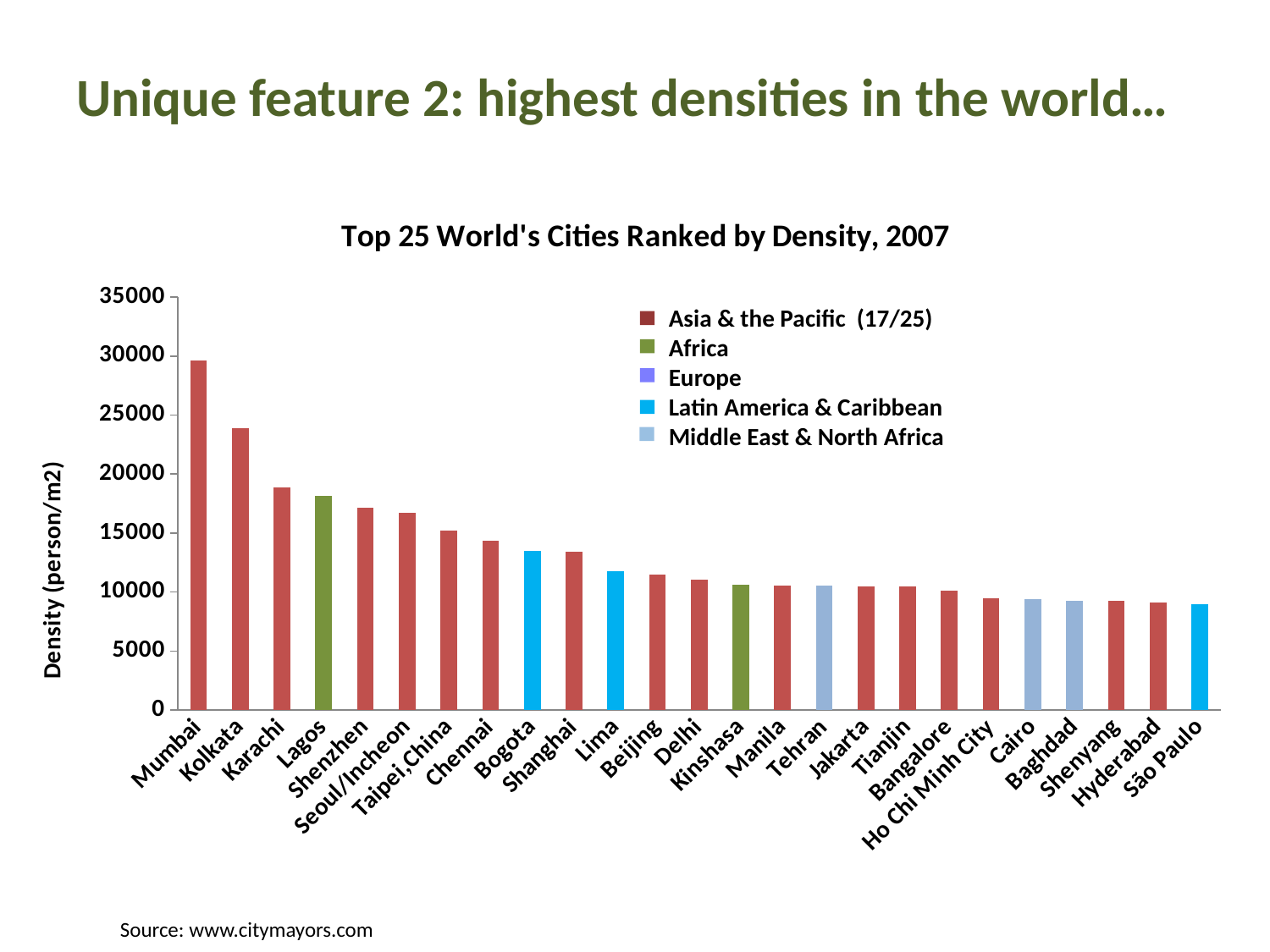
Which city has the higher density, Lagos or Shenzhen? Lagos Is the density for Mumbai greater or less than 25000? greater How many regions does the legend list? 5 Do the densities rise or fall moving from left to right along the x axis? fall Is the density for Hyderabad greater or less than 10000? less Which city has the highest density in the chart? Mumbai Which region does the legend mark as accounting for 17 of the 25 cities? Asia & the Pacific Which city has the lowest density in the chart? São Paulo Is the density for Chennai greater or less than 15000? less What kind of chart is shown on the slide? bar chart How many cities are plotted in the chart? 25